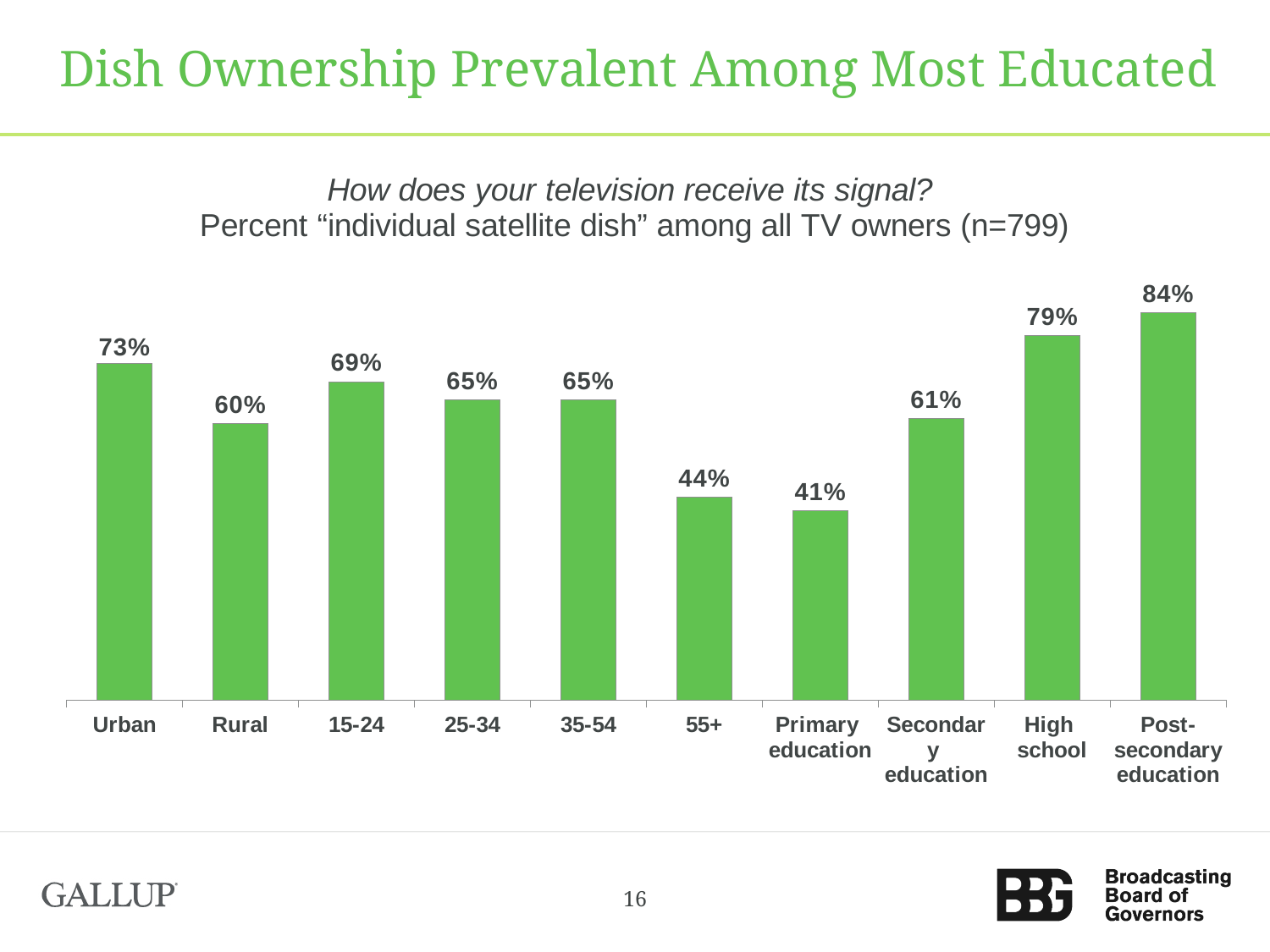
What is the difference in percentage points between Urban and Rural? 13 What is the value shown for Secondary education? 61% What is the difference in percentage points between Post-secondary education and Primary education? 43 How many categories are shown on the chart? 10 Which is larger, the value for 15-24 or the value for 55+? 15-24 What kind of chart is shown on the slide? Bar chart Do the values rise or fall across the education categories from Primary education to Post-secondary education? Rise Which category has the highest percentage of individual satellite dish ownership? Post-secondary education What percentage of urban TV owners receive their signal via an individual satellite dish? 73% Which category has the lowest percentage of individual satellite dish ownership? Primary education What is the value shown for the 55+ age group? 44% Which is larger, the value for High school or the value for Secondary education? High school